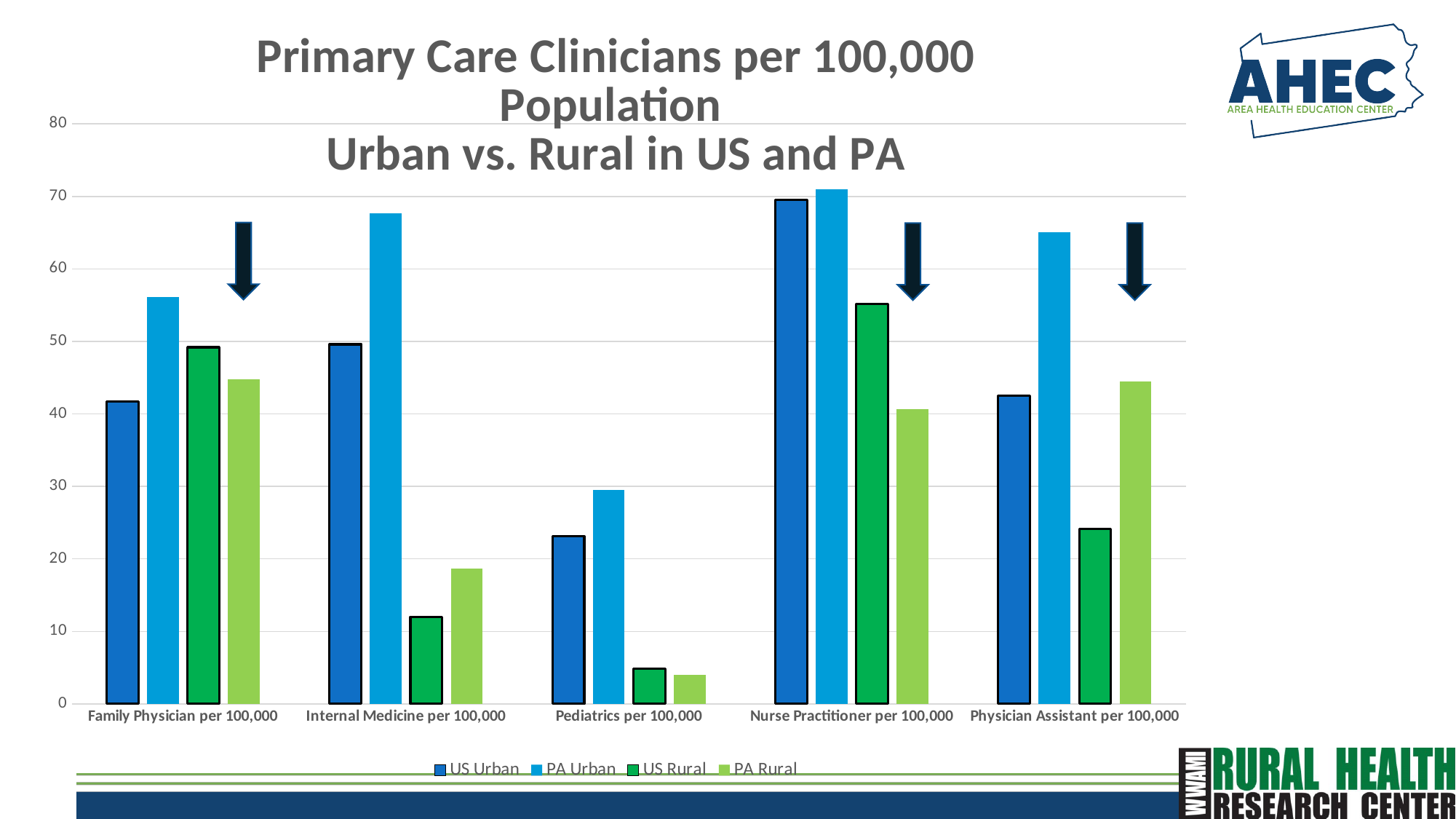
Which series is shown in light green in the legend? PA Rural Is the US Rural value for Internal Medicine per 100,000 greater or less than 20? less Is the PA Urban value for Internal Medicine per 100,000 greater or less than 60? greater Which category has the lowest PA Rural value? Pediatrics per 100,000 Which category has the highest PA Urban value? Nurse Practitioner per 100,000 For Family Physician per 100,000, which is larger: US Rural or PA Rural? US Rural What kind of chart is shown on the slide? bar chart How many series does the legend list? 4 Is the US Urban value for Nurse Practitioner per 100,000 greater or less than 60? greater How many clinician categories are shown on the x axis? 5 For Physician Assistant per 100,000, which is larger: US Rural or PA Rural? PA Rural What is the title of the chart? Primary Care Clinicians per 100,000 Population Urban vs. Rural in US and PA